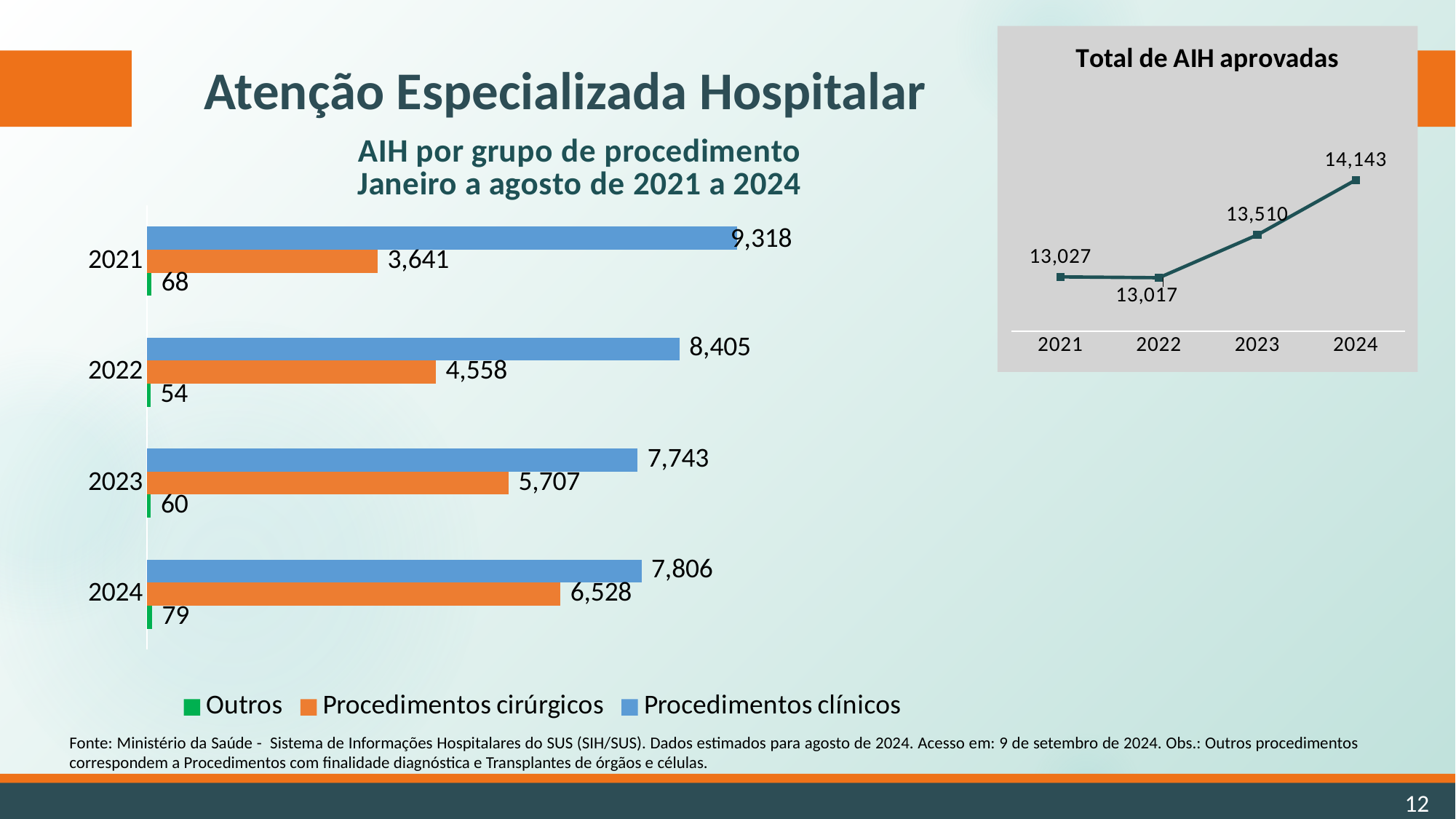
In the 'Total de AIH aprovadas' chart, what is the value for 2023? 13,510 In the 'AIH por grupo de procedimento' bar chart, how many series does the legend list? 3 In the 'AIH por grupo de procedimento' bar chart, what is the value of Procedimentos clínicos for 2021? 9,318 In the 'AIH por grupo de procedimento' bar chart, which year has the highest value for Procedimentos cirúrgicos? 2024 In the 'Total de AIH aprovadas' chart, which year has the lowest value? 2022 In the 'Total de AIH aprovadas' chart, what is the difference between 2024 and 2021? 1,116 What kind of chart is 'Total de AIH aprovadas'? Line chart In the 'AIH por grupo de procedimento' bar chart, which year has the lowest value for Procedimentos clínicos? 2023 In the 'AIH por grupo de procedimento' bar chart, what is the value of Outros for 2022? 54 What kind of chart is 'AIH por grupo de procedimento'? Bar chart In the 'AIH por grupo de procedimento' bar chart, what is the value of Procedimentos cirúrgicos for 2024? 6,528 In the 'AIH por grupo de procedimento' bar chart, what is the difference between Procedimentos clínicos and Procedimentos cirúrgicos in 2023? 2,036